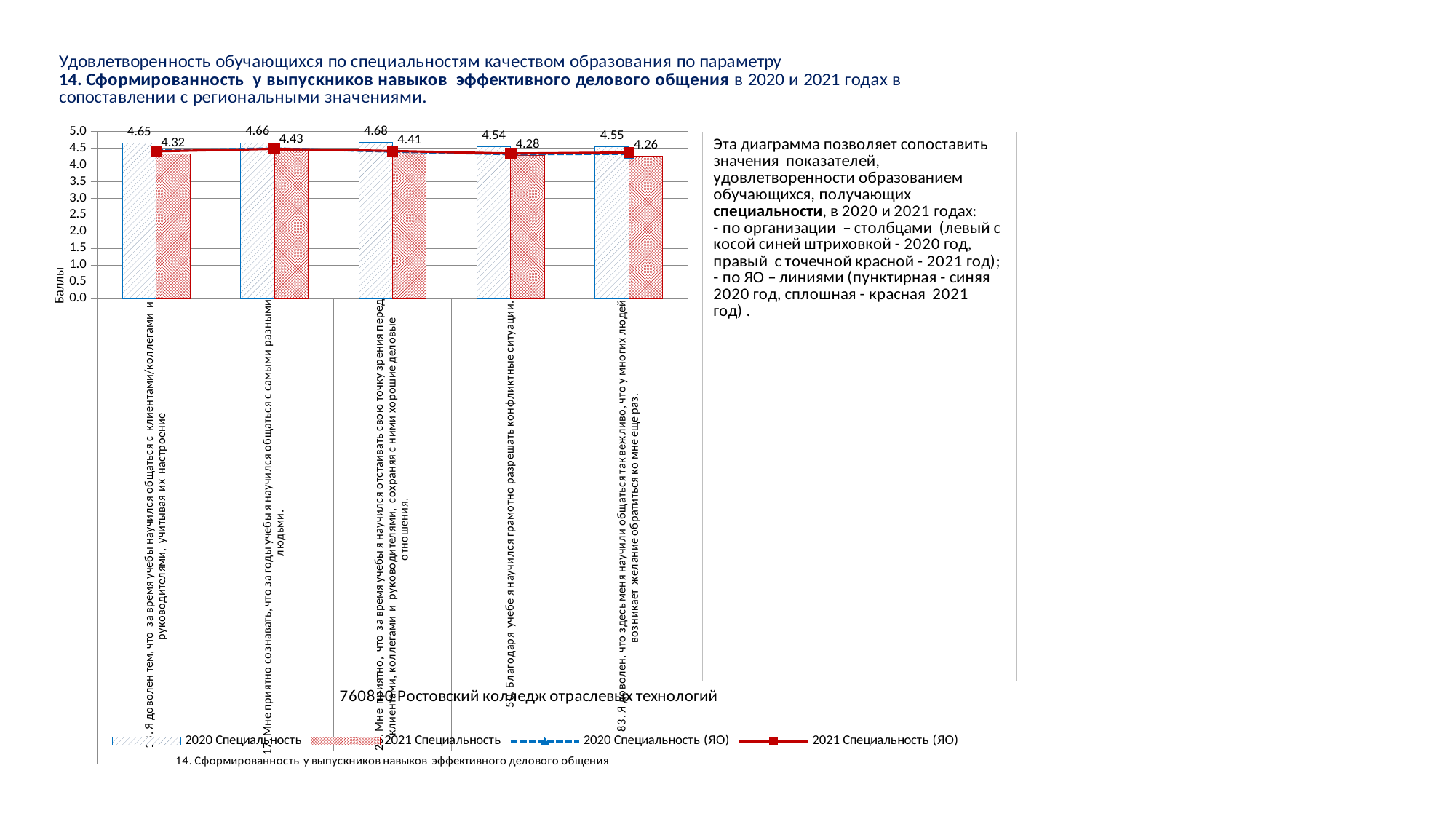
Which category has the lowest 2021 Специальность value? 83. Я доволен, что здесь меня научили общаться так вежливо... (4.26) Is the 2021 Специальность value for the category "Благодаря учебе я научился грамотно разрешать конфликтные ситуации" greater or less than 4.5? less What is the 2020 Специальность value for the first category ("Я доволен тем, что за время учебы научился общаться с клиентами/коллегами и руководителями...")? 4.65 How many categories are shown on the x axis of the chart? 5 What is the difference between the 2020 and 2021 Специальность values for the first category? 0.33 What kind of chart is shown on the slide? Combined bar and line chart What is the 2021 Специальность value for the category "Благодаря учебе я научился грамотно разрешать конфликтные ситуации"? 4.28 What is the label of the vertical axis of the chart? Баллы How many series does the chart legend list? 4 Which category has the highest 2020 Специальность value? Мне приятно, что за время учебы я научился отстаивать свою точку зрения перед клиентами, коллегами и руководителями (4.68) What is the 2021 Специальность value for the last category ("83. Я доволен, что здесь меня научили общаться так вежливо...")? 4.26 For the category "17. Мне приятно сознавать, что за годы учебы я научился общаться с самыми разными людьми", which is larger: the 2020 or the 2021 Специальность value? 2020 (4.66)